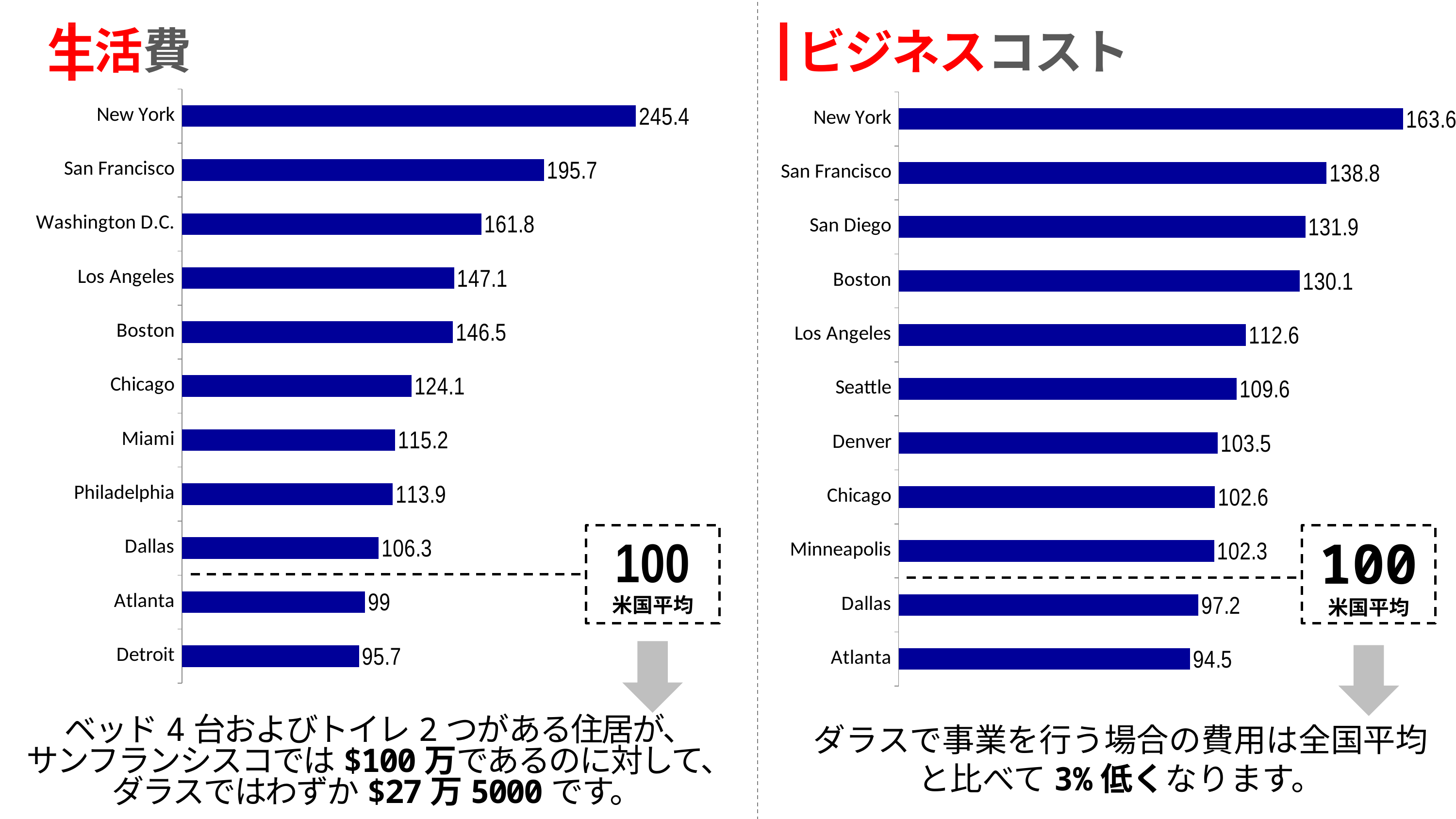
What kind of chart is the right chart (ビジネスコスト)? Bar chart In the left chart (生活費), which city has the highest value? New York In the right chart (ビジネスコスト), which city has the lowest value? Atlanta In the left chart (生活費), what is the difference between New York and San Francisco? 49.7 How many cities are shown in the right chart (ビジネスコスト)? 11 In the left chart (生活費), what value does the dashed reference line labelled 米国平均 represent? 100 How many cities are shown in the left chart (生活費)? 11 In the right chart (ビジネスコスト), what is the difference between San Francisco and Dallas? 41.6 In the right chart (ビジネスコスト), which is larger, Boston or Los Angeles? Boston In the left chart (生活費), which is larger, Chicago or Miami? Chicago In the right chart (ビジネスコスト), what is the value for Seattle? 109.6 In the left chart (生活費), what is the value for Dallas? 106.3